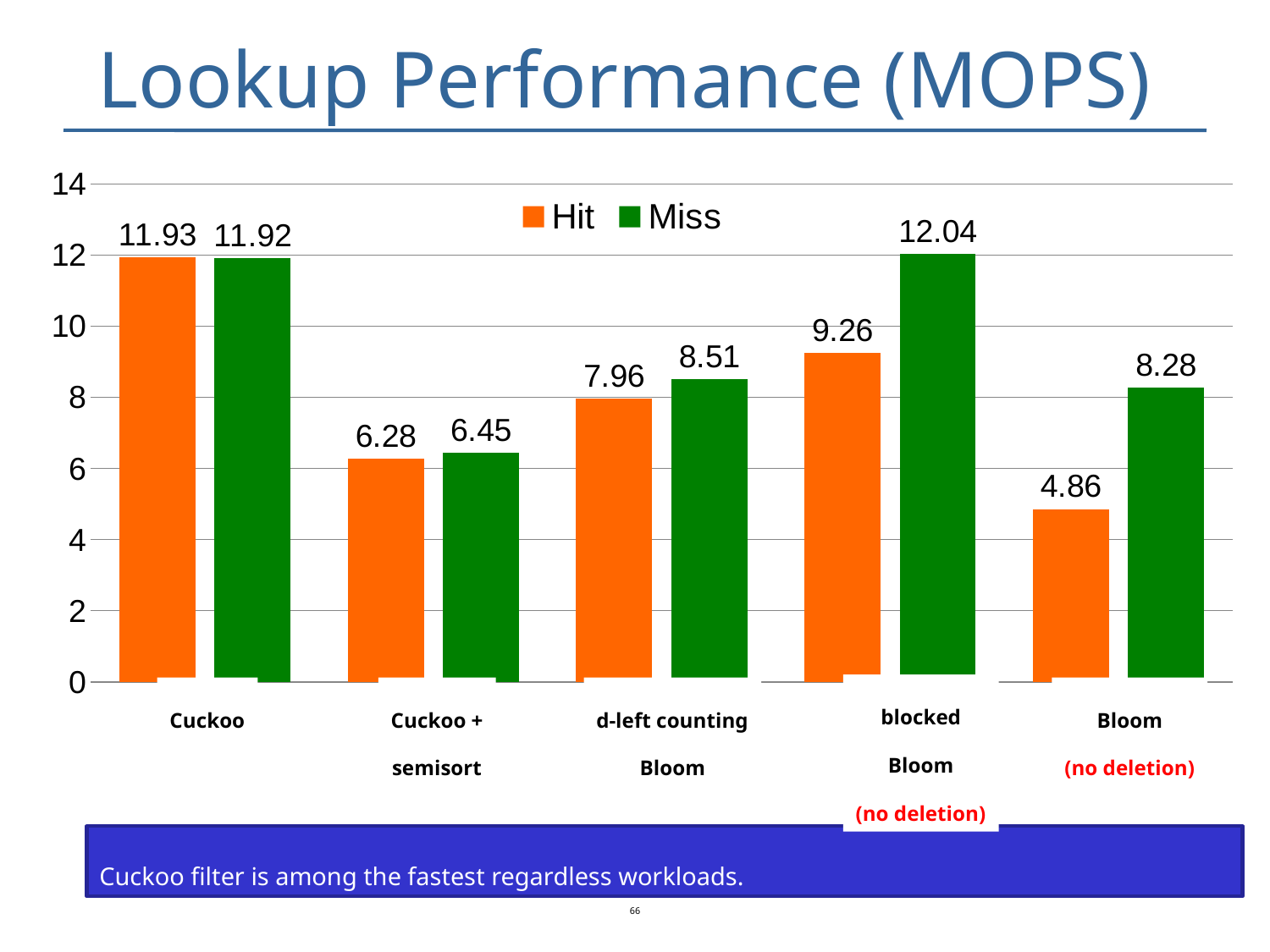
What is the Miss value for d-left counting Bloom? 8.51 Which category has the highest Miss value? blocked Bloom (no deletion) How many categories are shown on the x axis? 5 What kind of chart is shown on the slide? bar chart How many series does the legend list? 2 What colour represents the Miss series? green What is the difference between the Miss and Hit values for Bloom (no deletion)? 3.42 What is the Hit value for Bloom (no deletion)? 4.86 Which category has the lowest Hit value? Bloom (no deletion) What is the Miss value for blocked Bloom (no deletion)? 12.04 Which is larger, the Hit value for Cuckoo + semisort or the Hit value for d-left counting Bloom? d-left counting Bloom What is the Hit value for Cuckoo? 11.93